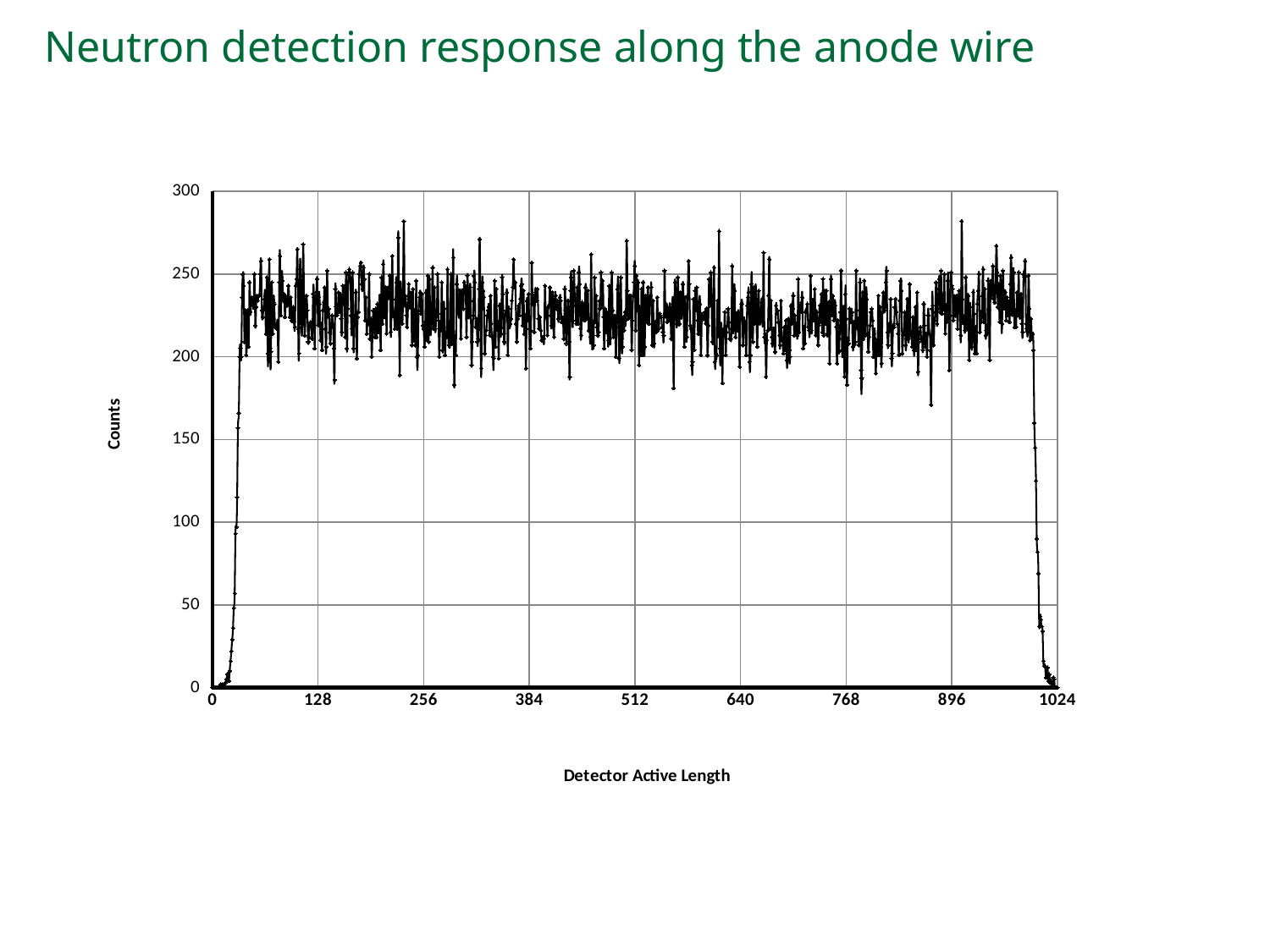
Are the counts in the middle region of the chart (between 128 and 896) mostly above or below 200? above Is the value at a detector active length of 1024 greater or less than 100? less Near the right end of the x axis, just before 1024, do the counts rise or fall? fall Is the value at a detector active length of 0 greater or less than 50? less Near the left end of the x axis, just after 0, do the counts rise or fall? rise What is the label of the vertical axis of the chart? Counts What is the label of the horizontal axis of the chart? Detector Active Length What kind of chart is shown on the slide? line chart Between detector active lengths of 128 and 896, do the counts rise steadily, fall steadily, or stay roughly flat? roughly flat